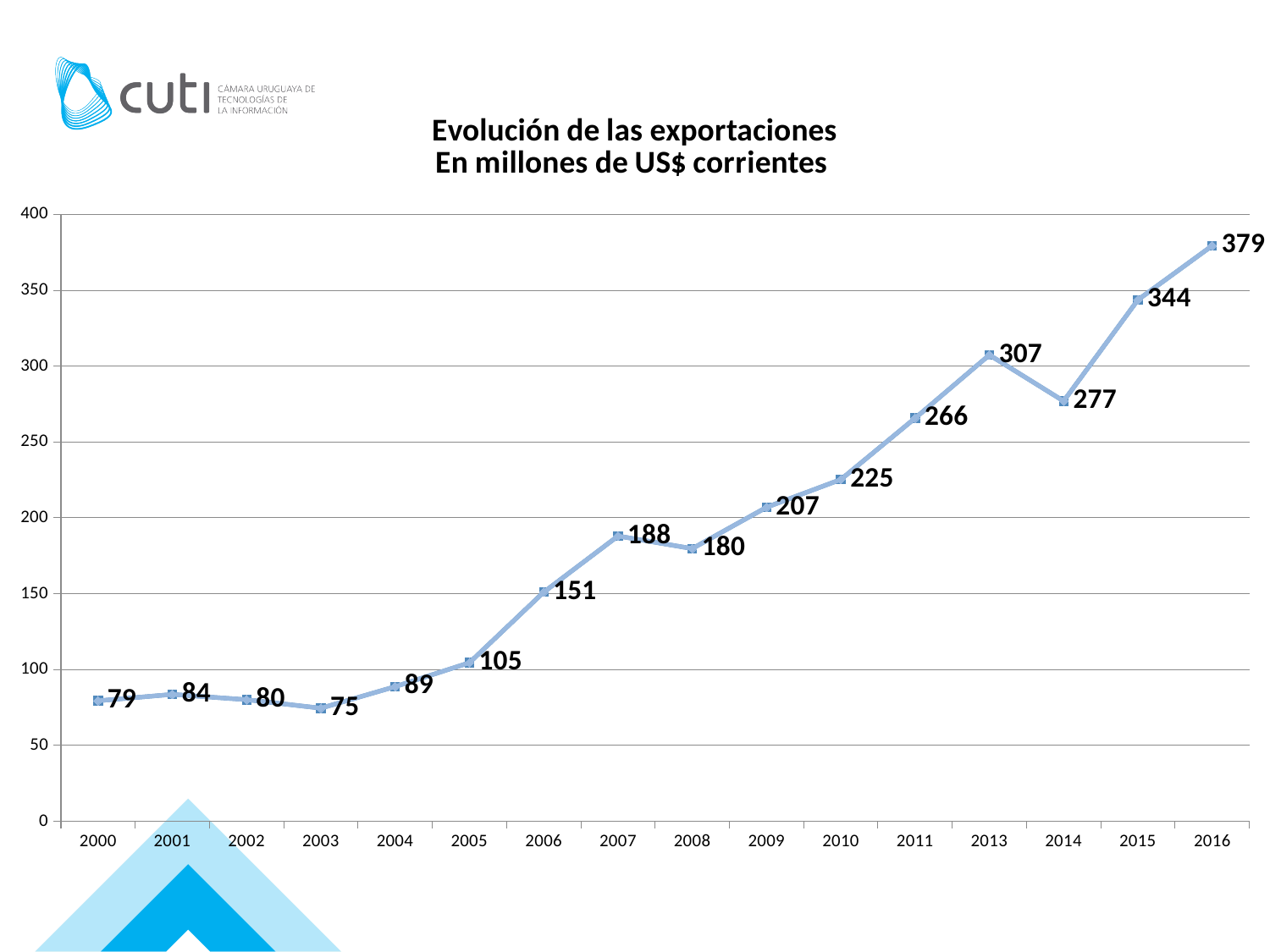
Which year has the highest value? 2016 How many years are plotted on the x axis? 16 What is the value for 2008? 180 What is the difference between the values for 2015 and 2014? 67 Which year has the lowest value? 2003 What is the difference between the values for 2016 and 2000? 300 Which is larger, the value for 2013 or the value for 2014? 2013 What is the value for 2003? 75 Do the values generally rise or fall from 2000 to 2016? Rise What kind of chart is shown on the slide? Line chart Which is larger, the value for 2007 or the value for 2008? 2007 What is the value for 2016? 379